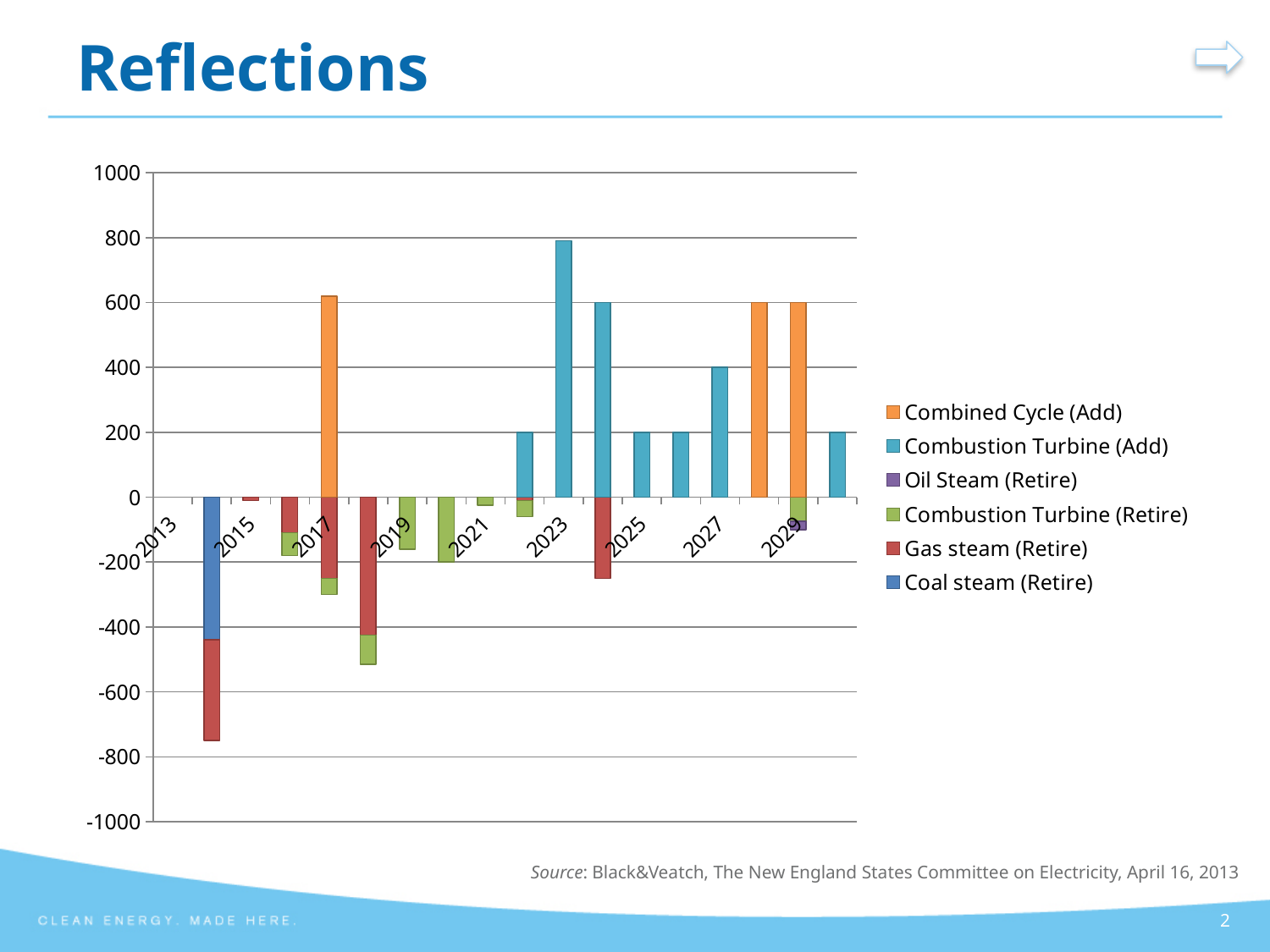
How many series does the legend list? 6 Is the value for Combined Cycle (Add) in 2017 greater or less than 400? greater Is the value for Coal steam (Retire) greater or less than -200? less Which year has the tallest positive bar? 2023 What is the value of Combustion Turbine (Add) in 2025? 200 What kind of chart is shown on the slide? bar chart Which is larger: Combustion Turbine (Add) in 2023 or Combustion Turbine (Add) in 2027? 2023 Which series is listed first in the legend? Combined Cycle (Add) Is the value for Combustion Turbine (Add) in 2023 greater or less than 600? greater What is the value of Combustion Turbine (Add) in 2027? 400 How many of the legend series are labelled as (Retire)? 4